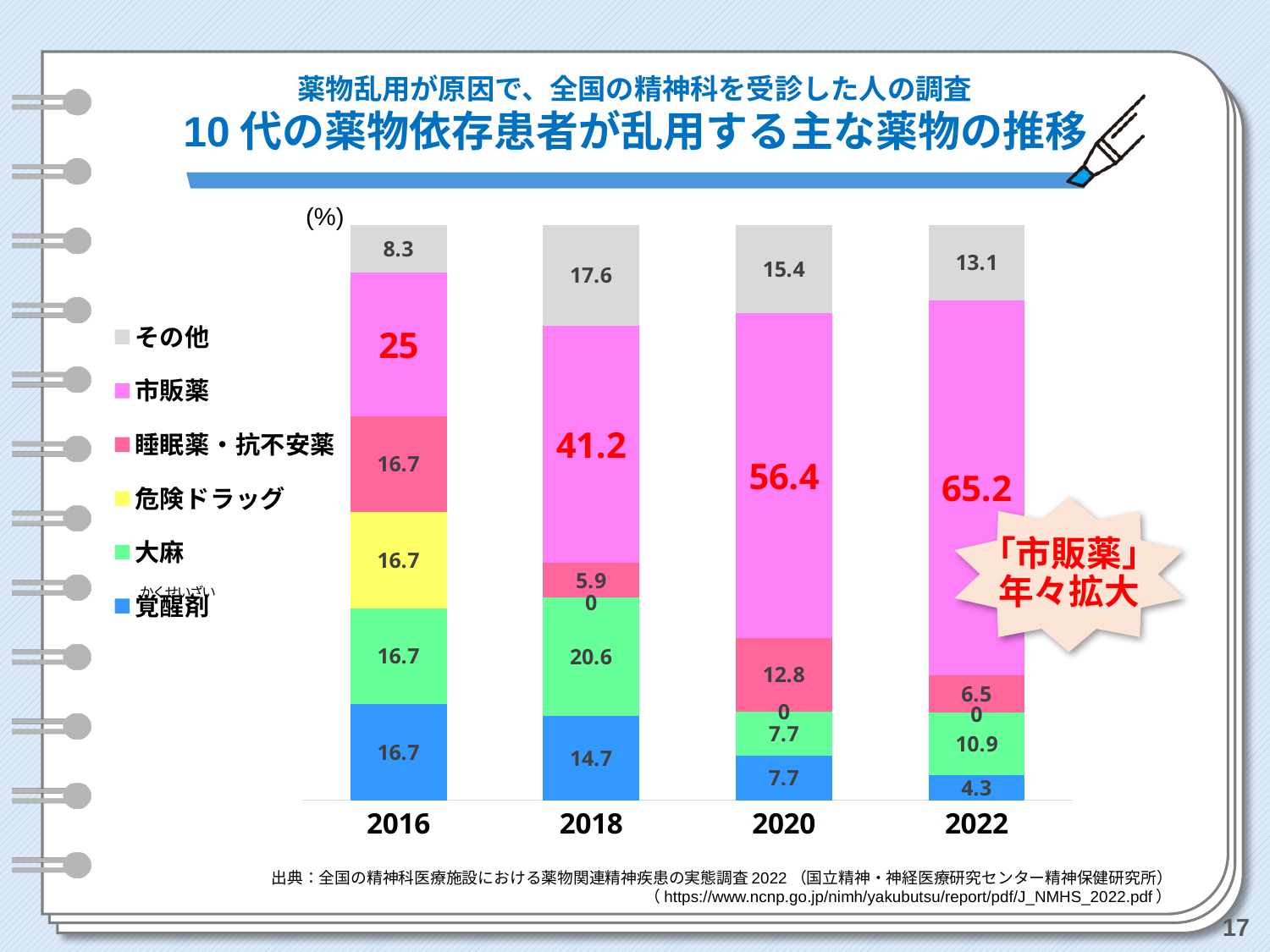
What is the difference between the 市販薬 values for 2022 and 2016? 40.2 In which year is the value for 市販薬 highest? 2022 What is the value for その他 in 2016? 8.3 In which year is the value for 覚醒剤 lowest? 2022 How many years (categories) are shown on the x axis? 4 What is the value for 睡眠薬・抗不安薬 in 2020? 12.8 What type of chart is shown on the slide? Stacked bar chart Does the value for 市販薬 rise or fall from 2016 to 2022? Rise How many series does the legend list? 6 Which is larger in 2018: the value for 大麻 or the value for 覚醒剤? 大麻 What is the value for 覚醒剤 in 2018? 14.7 What is the value for 市販薬 in 2022? 65.2